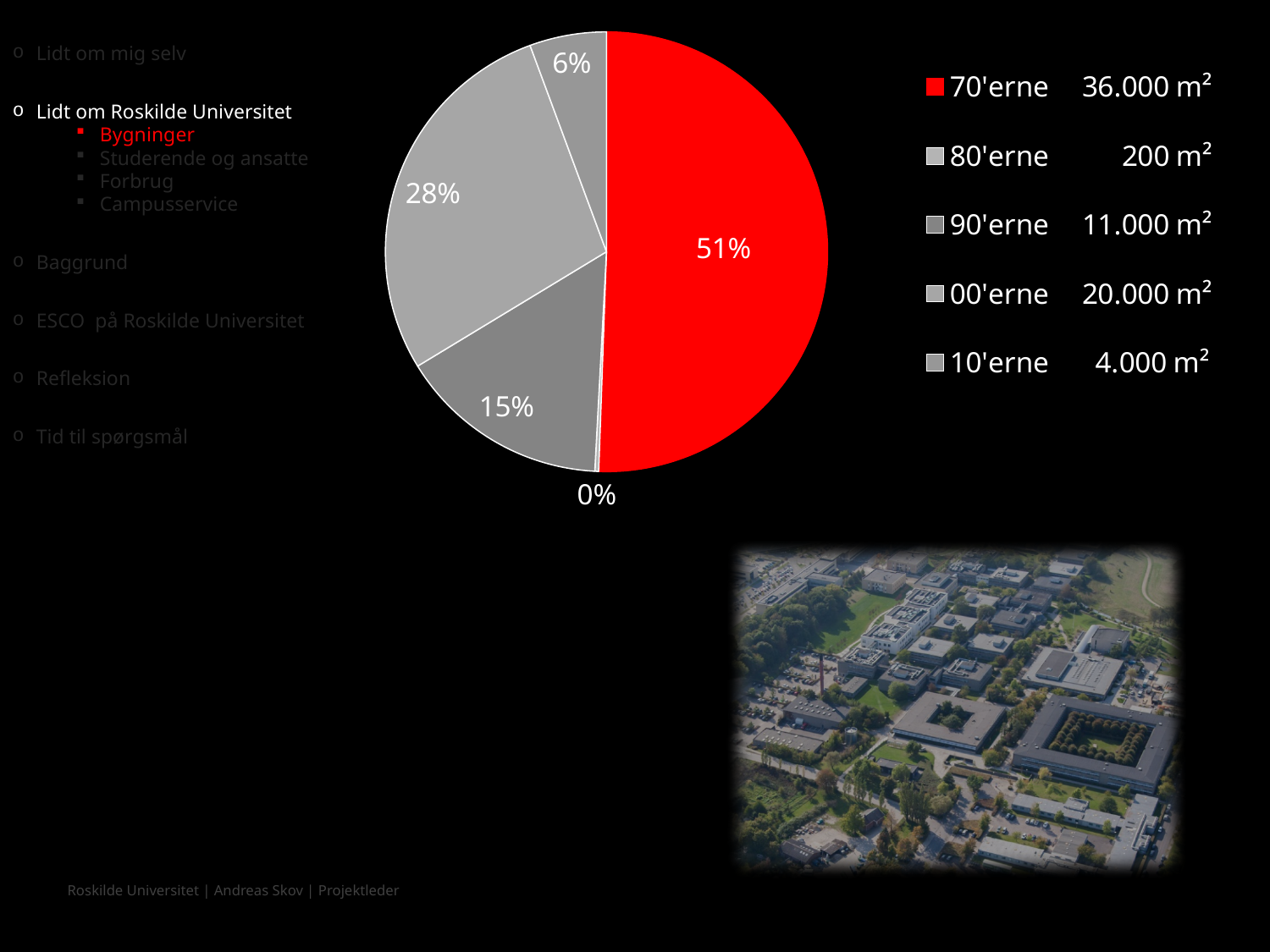
What share of the pie does the 70'erne slice represent? 51% What share of the pie does the 00'erne slice represent? 28% What kind of chart is shown on the slide? pie chart What is the difference in area between 70'erne and 00'erne according to the legend? 16.000 m² Which category has the largest slice of the pie? 70'erne What area in m² is listed in the legend for 00'erne? 20.000 m² How many categories does the legend of the pie chart list? 5 What area in m² is listed in the legend for 70'erne? 36.000 m² What area in m² is listed in the legend for 80'erne? 200 m² What share of the pie does the 90'erne slice represent? 15% Which category has the smallest slice of the pie? 80'erne